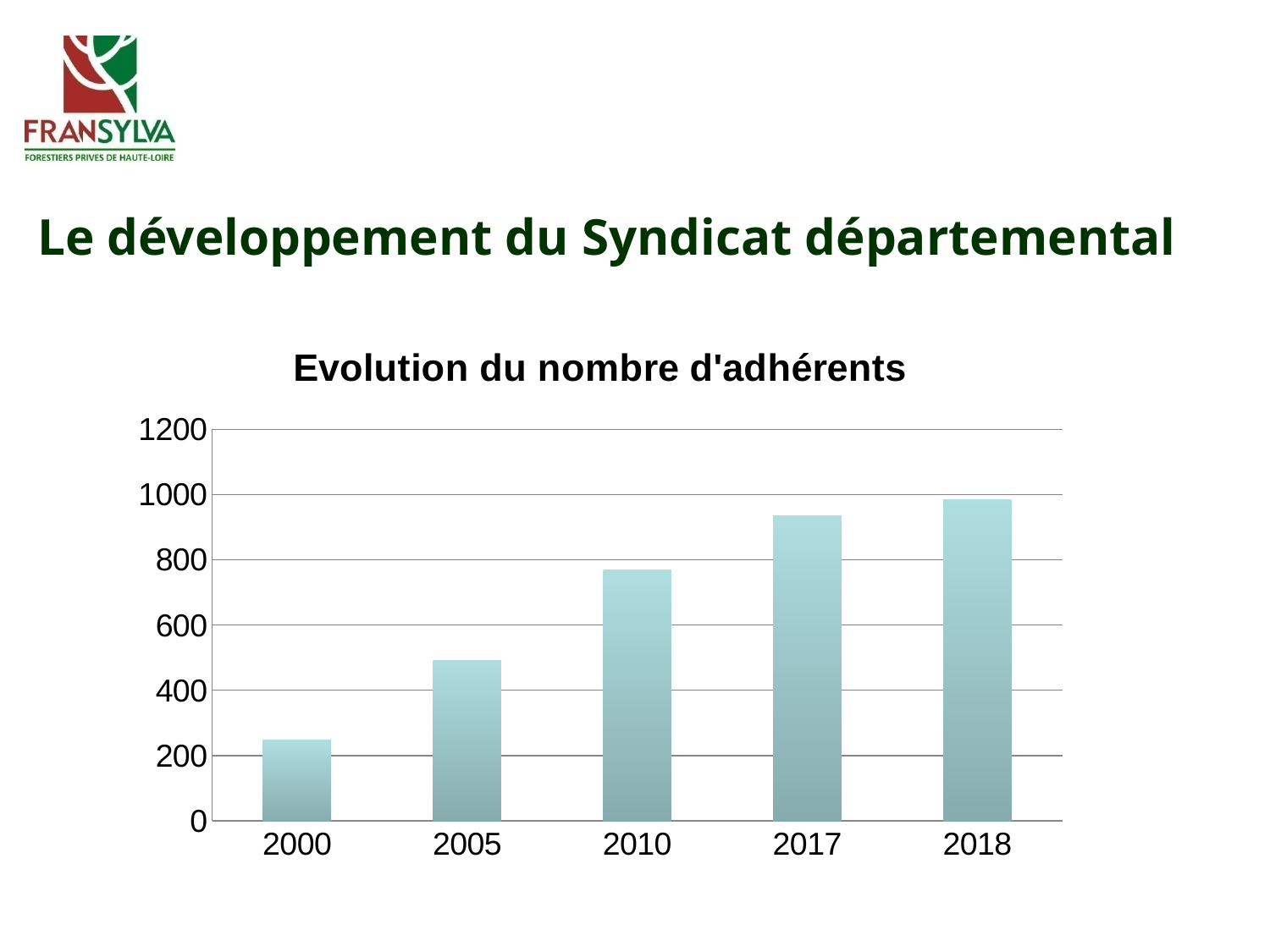
Is the value for 2000 greater or less than 400? less Which is larger, the value for 2005 or the value for 2010? 2010 Is the value for 2018 greater or less than 800? greater Do the values rise or fall from 2000 to 2018 in the chart? rise Is the value for 2005 greater or less than 400? greater How many years are shown on the x axis of the chart? 5 What kind of chart is shown on the slide? bar chart What is the title of the chart? Evolution du nombre d'adhérents Which year has the lowest number of members in the chart? 2000 Which year has the highest number of members in the chart? 2018